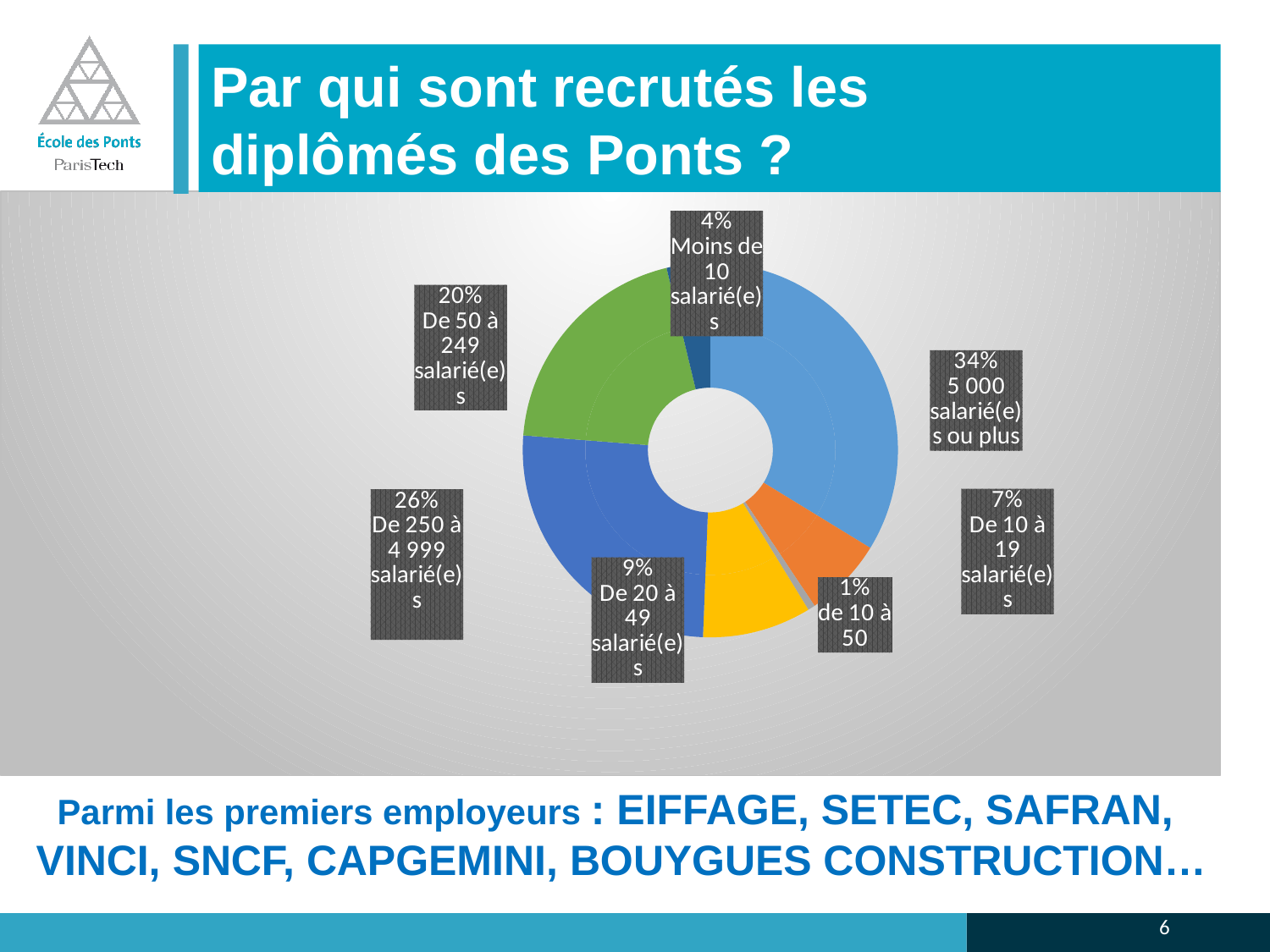
Which is larger: the share for 'De 50 à 249 salarié(e)s' or for 'De 10 à 19 salarié(e)s'? De 50 à 249 salarié(e)s What kind of chart is shown on the slide? Doughnut (pie) chart What is the difference in percentage points between '5 000 salarié(e)s ou plus' and 'De 250 à 4 999 salarié(e)s'? 8 percentage points What percentage is shown for 'De 20 à 49 salarié(e)s'? 9% What percentage is shown for 'De 50 à 249 salarié(e)s'? 20% What percentage corresponds to the category 'De 250 à 4 999 salarié(e)s'? 26% What share of graduates are recruited by companies with 5 000 salarié(e)s ou plus? 34% What is the title of the slide containing the chart? Par qui sont recrutés les diplômés des Ponts ? What is the smallest percentage shown on the chart? 1% What percentage is shown for 'Moins de 10 salarié(e)s'? 4% Which category has the largest share of the chart? 5 000 salarié(e)s ou plus How many categories (slices) does the chart show? 7